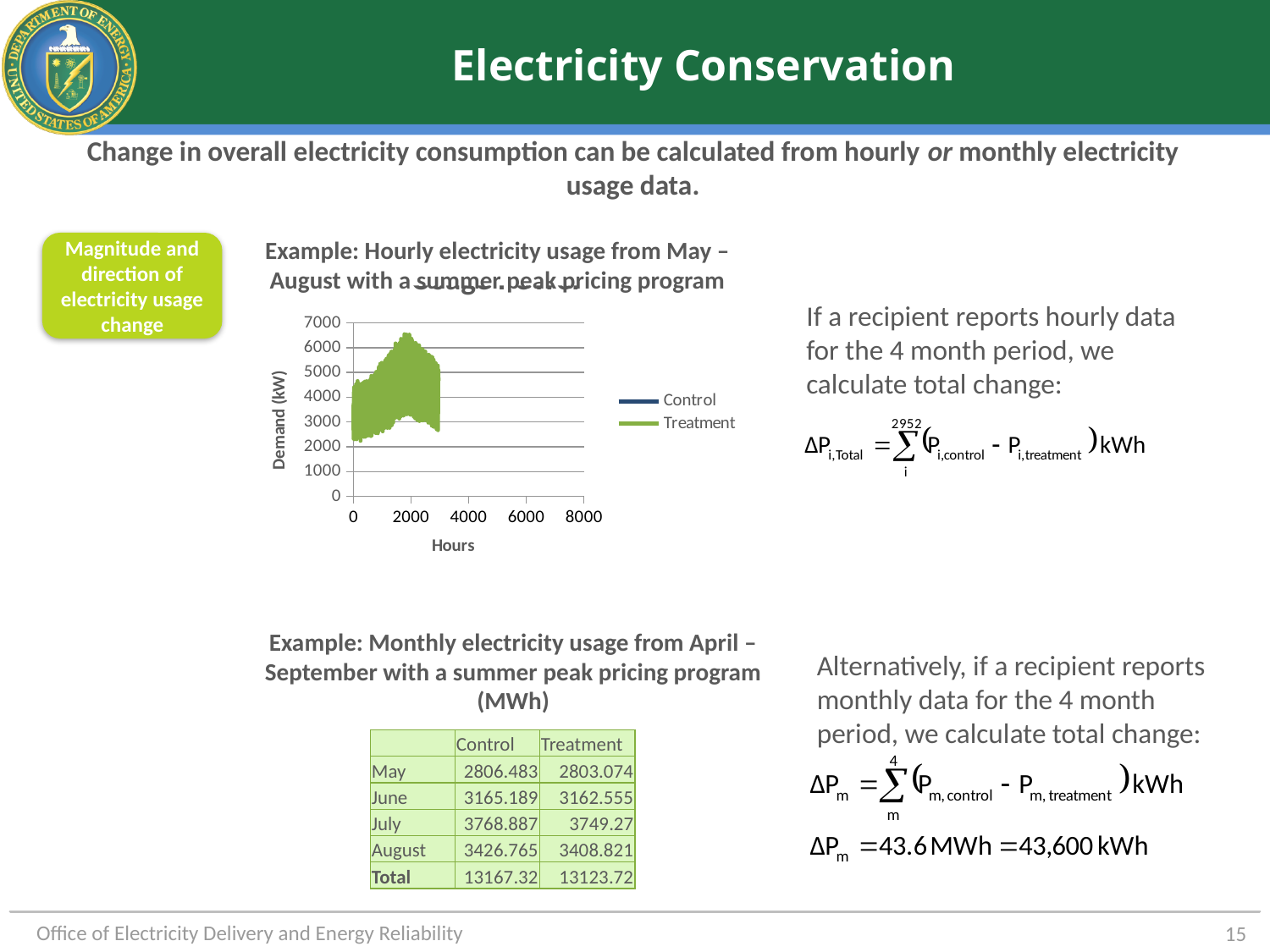
What is the highest value shown on the chart's vertical axis? 7000 Does the upper envelope of demand rise or fall between hour 2000 and hour 3000 on the chart? fall Is the last hour with plotted data on the chart greater or less than 4000 hours? less Does the upper envelope of demand rise or fall between hour 0 and hour 2000 on the chart? rise What is the label of the chart's vertical axis? Demand (kW) What kind of chart is shown on the slide? line chart Is the lowest demand shown on the chart greater or less than 3000 kW? less What are the two series named in the chart's legend? Control and Treatment How many series does the chart's legend list? 2